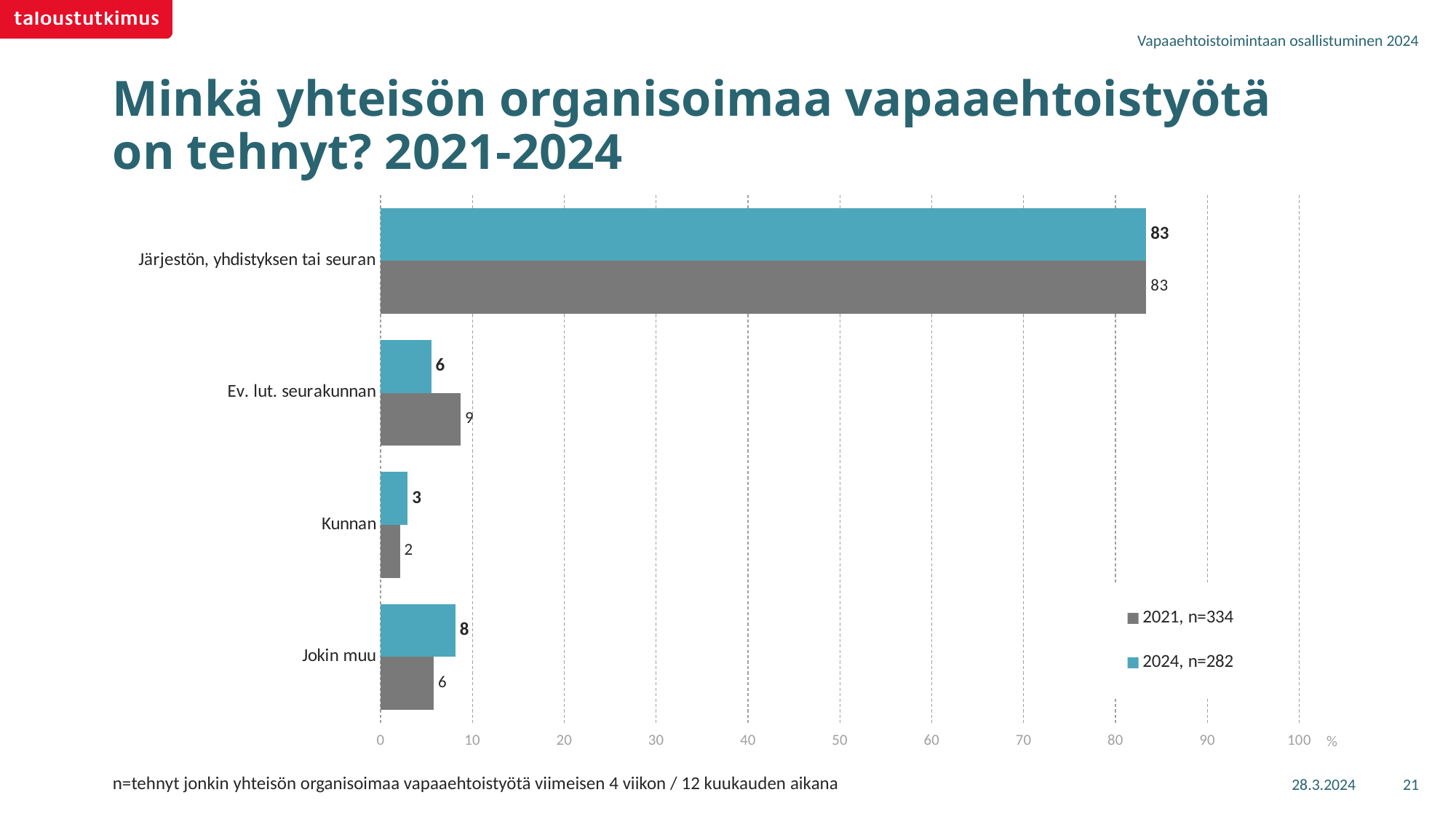
Which is larger for Jokin muu, the 2021 value or the 2024 value? 2024 What is the difference between the 2021 and 2024 values for Ev. lut. seurakunnan? 3 How many series does the legend list? 2 What is the sample size (n) for the 2024 series according to the legend? 282 What is the 2024 value for Kunnan? 3 What is the 2021 value for Jokin muu? 6 What is the 2021 value for Ev. lut. seurakunnan? 9 How many categories are shown on the chart? 4 Which category has the highest 2024 value? Järjestön, yhdistyksen tai seuran What kind of chart is shown on the slide? Bar chart Which category has the lowest 2021 value? Kunnan What is the 2024 value for Järjestön, yhdistyksen tai seuran? 83